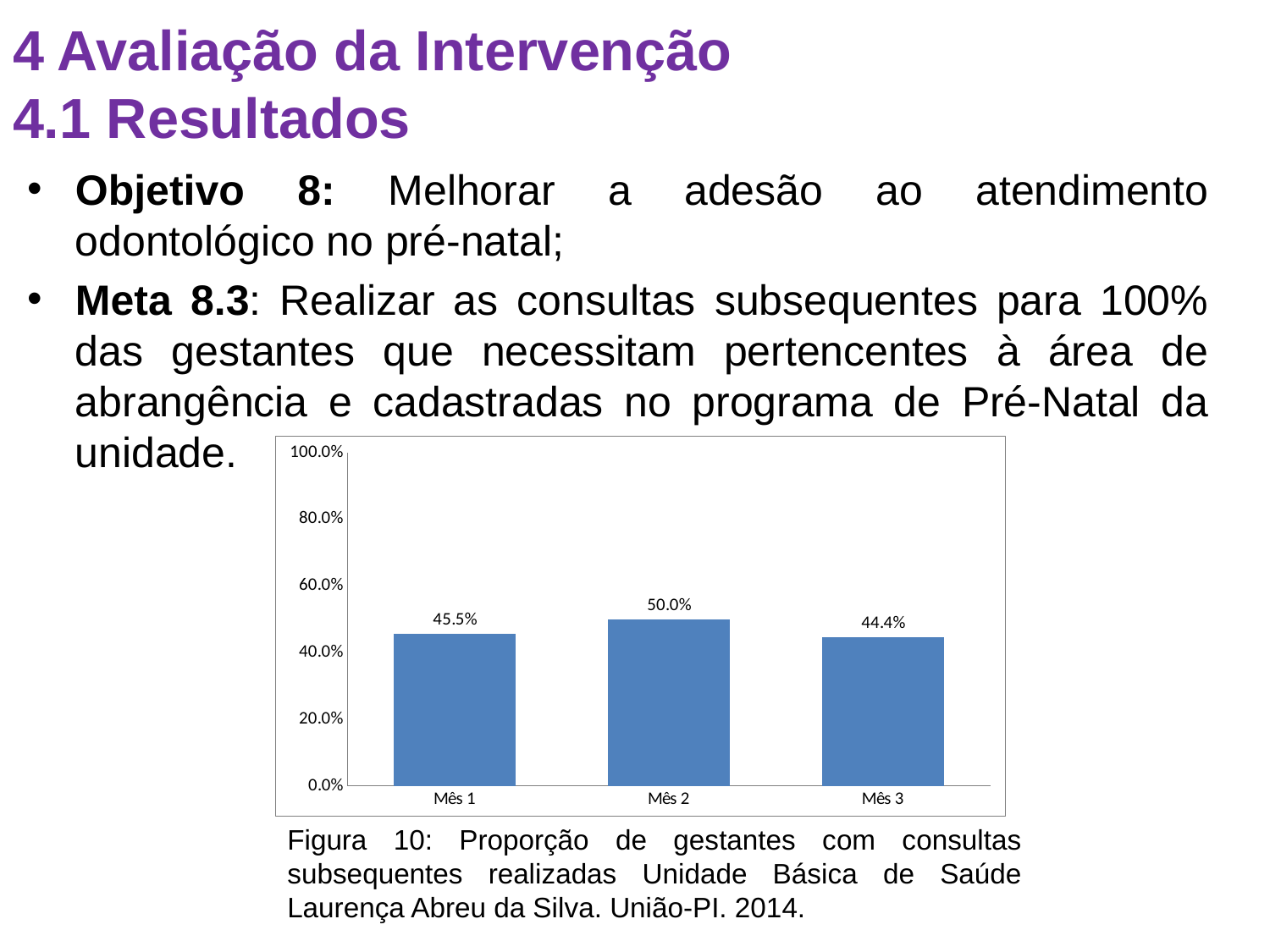
What is the maximum value shown on the y axis? 100.0% What is the value for Mês 1? 45.5% How many months are shown on the x axis? 3 What is the difference between the values for Mês 2 and Mês 3? 5.6% Is the value for Mês 2 greater or less than 40.0%? greater What is the difference between the values for Mês 2 and Mês 1? 4.5% Which month has the lowest value? Mês 3 Which month has the highest value? Mês 2 Which is larger, the value for Mês 1 or the value for Mês 3? Mês 1 What kind of chart is shown on the slide? bar chart What is the value for Mês 3? 44.4% What is the value for Mês 2? 50.0%